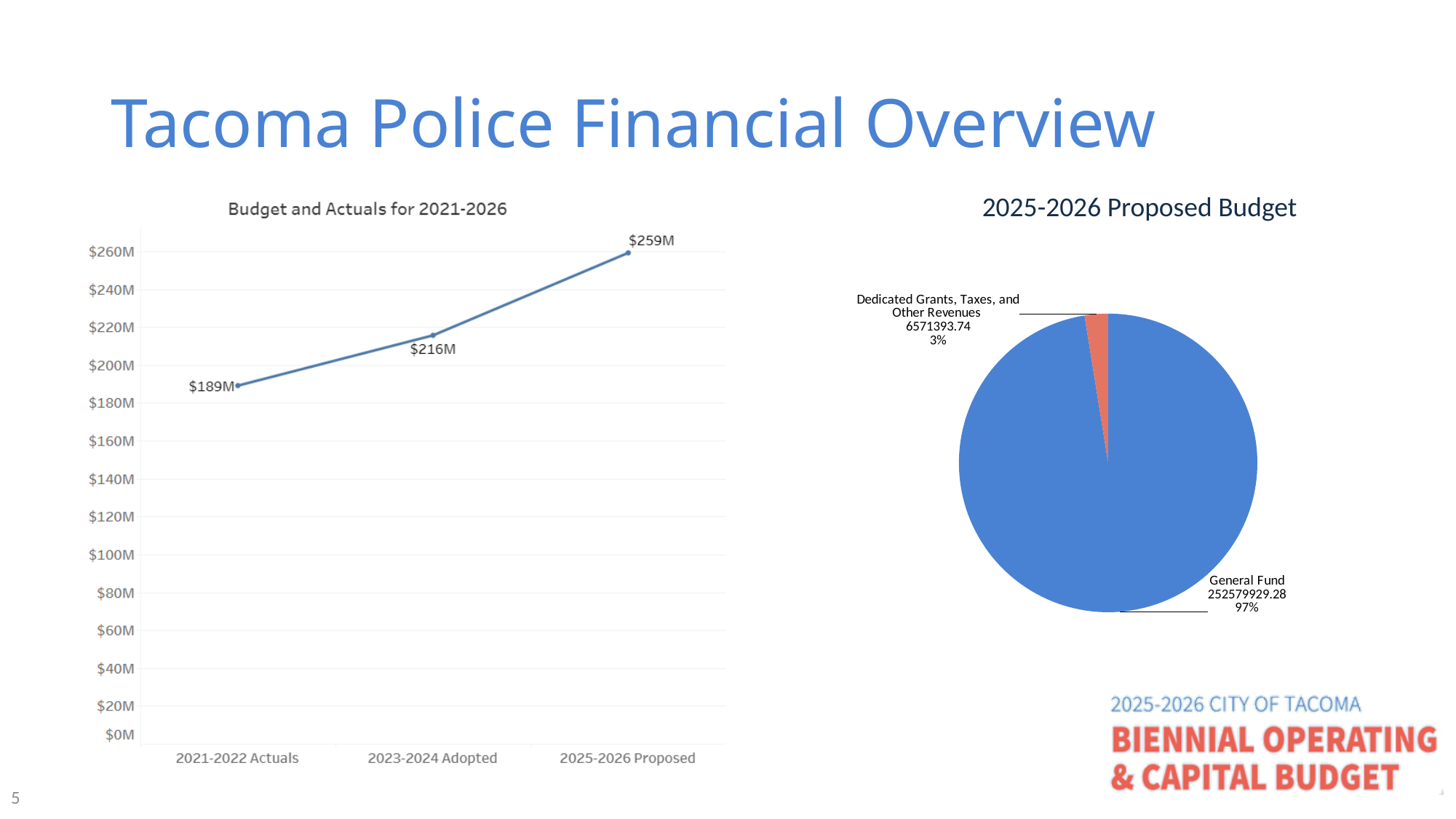
In the '2025-2026 Proposed Budget' pie chart, what share does General Fund have? 97% In the 'Budget and Actuals for 2021-2026' chart, which category has the lowest value? 2021-2022 Actuals In the '2025-2026 Proposed Budget' pie chart, what is the value for Dedicated Grants, Taxes, and Other Revenues? 6571393.74 In the 'Budget and Actuals for 2021-2026' chart, do the values rise or fall from left to right along the x axis? rise In the 'Budget and Actuals for 2021-2026' chart, what is the difference between the 2025-2026 Proposed value and the 2021-2022 Actuals value? $70M In the 'Budget and Actuals for 2021-2026' chart, how many data points are plotted? 3 What kind of chart is 'Budget and Actuals for 2021-2026'? line chart In the 'Budget and Actuals for 2021-2026' chart, which category has the highest value? 2025-2026 Proposed In the '2025-2026 Proposed Budget' pie chart, which slice is larger: General Fund or Dedicated Grants, Taxes, and Other Revenues? General Fund In the 'Budget and Actuals for 2021-2026' chart, what is the value for 2023-2024 Adopted? $216M In the 'Budget and Actuals for 2021-2026' chart, what is the value for 2025-2026 Proposed? $259M In the 'Budget and Actuals for 2021-2026' chart, what is the value for 2021-2022 Actuals? $189M